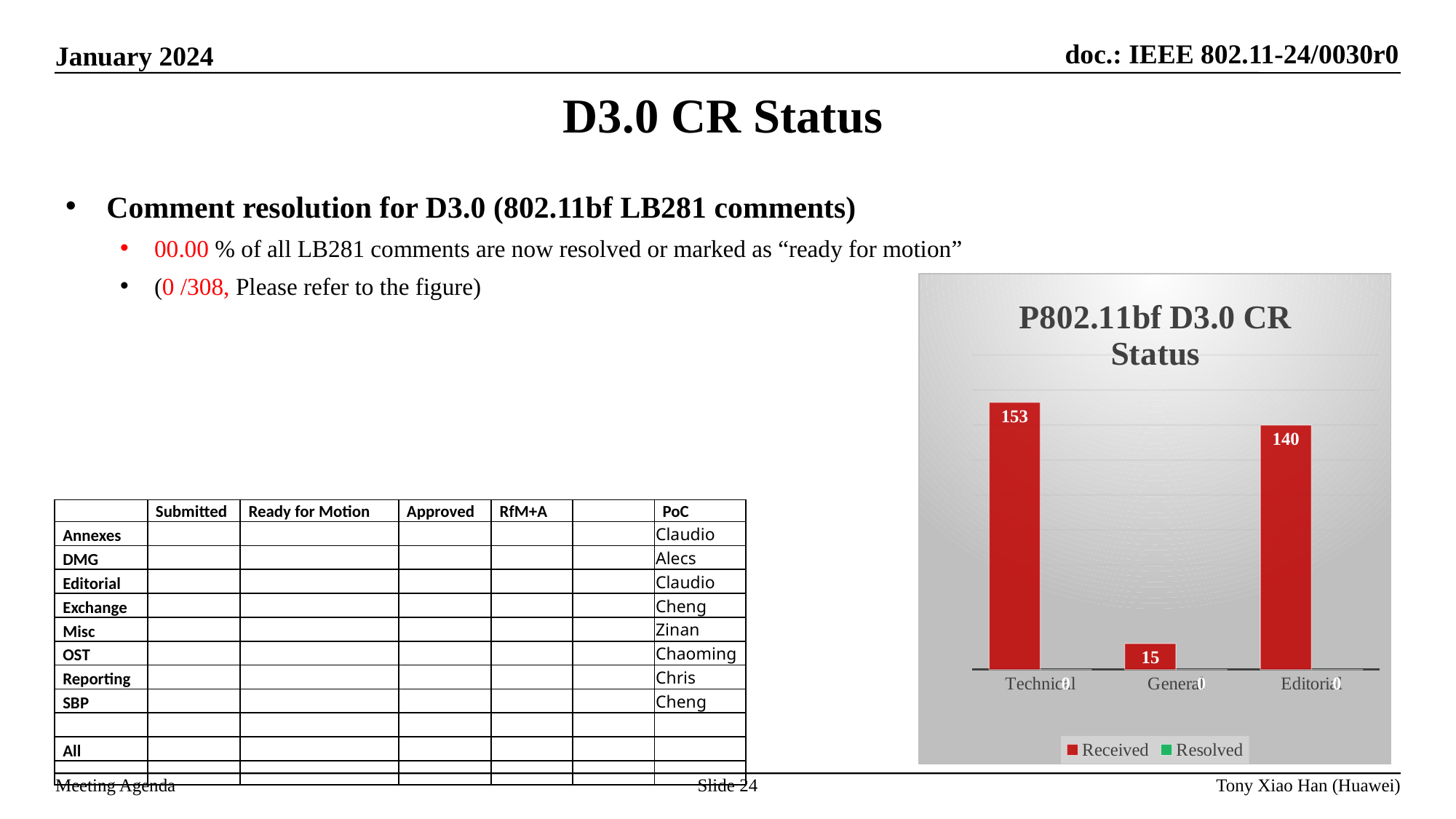
Which category has the highest Received value? Technical What is the Received value for Technical? 153 Which series are listed in the chart legend? Received, Resolved What is the title of the chart? P802.11bf D3.0 CR Status Which has a larger Received value, General or Editorial? Editorial What is the Received value for Editorial? 140 How many categories are shown on the x axis of the chart? 3 What type of chart is shown on the slide? bar chart How many series does the chart legend list? 2 What is the difference between the Received values for Technical and Editorial? 13 What is the Received value for General? 15 Which category has the lowest Received value? General